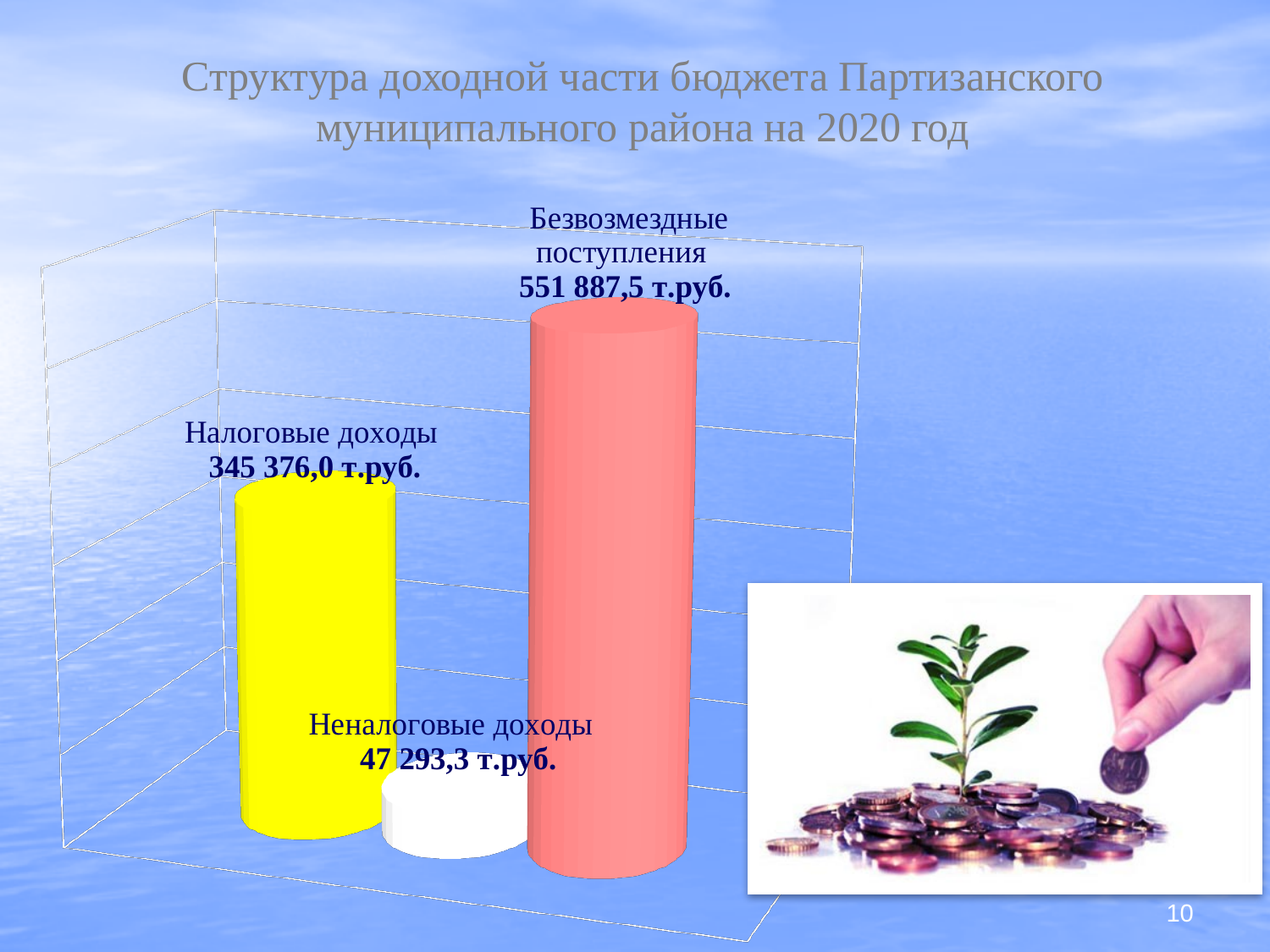
What is the difference between Безвозмездные поступления and Налоговые доходы? 206 511,5 т.руб. What is the value shown for Неналоговые доходы? 47 293,3 т.руб. Which category has the highest value? Безвозмездные поступления What is the difference between Налоговые доходы and Неналоговые доходы? 298 082,7 т.руб. How many categories are plotted in the chart? 3 Which is larger, Безвозмездные поступления or Налоговые доходы? Безвозмездные поступления What is the value shown for Безвозмездные поступления? 551 887,5 т.руб. What colour is the bar for Безвозмездные поступления? Red Which category has the lowest value? Неналоговые доходы What kind of chart is shown on the slide? Bar chart What is the value shown for Налоговые доходы? 345 376,0 т.руб. Which is larger, Налоговые доходы or Неналоговые доходы? Налоговые доходы